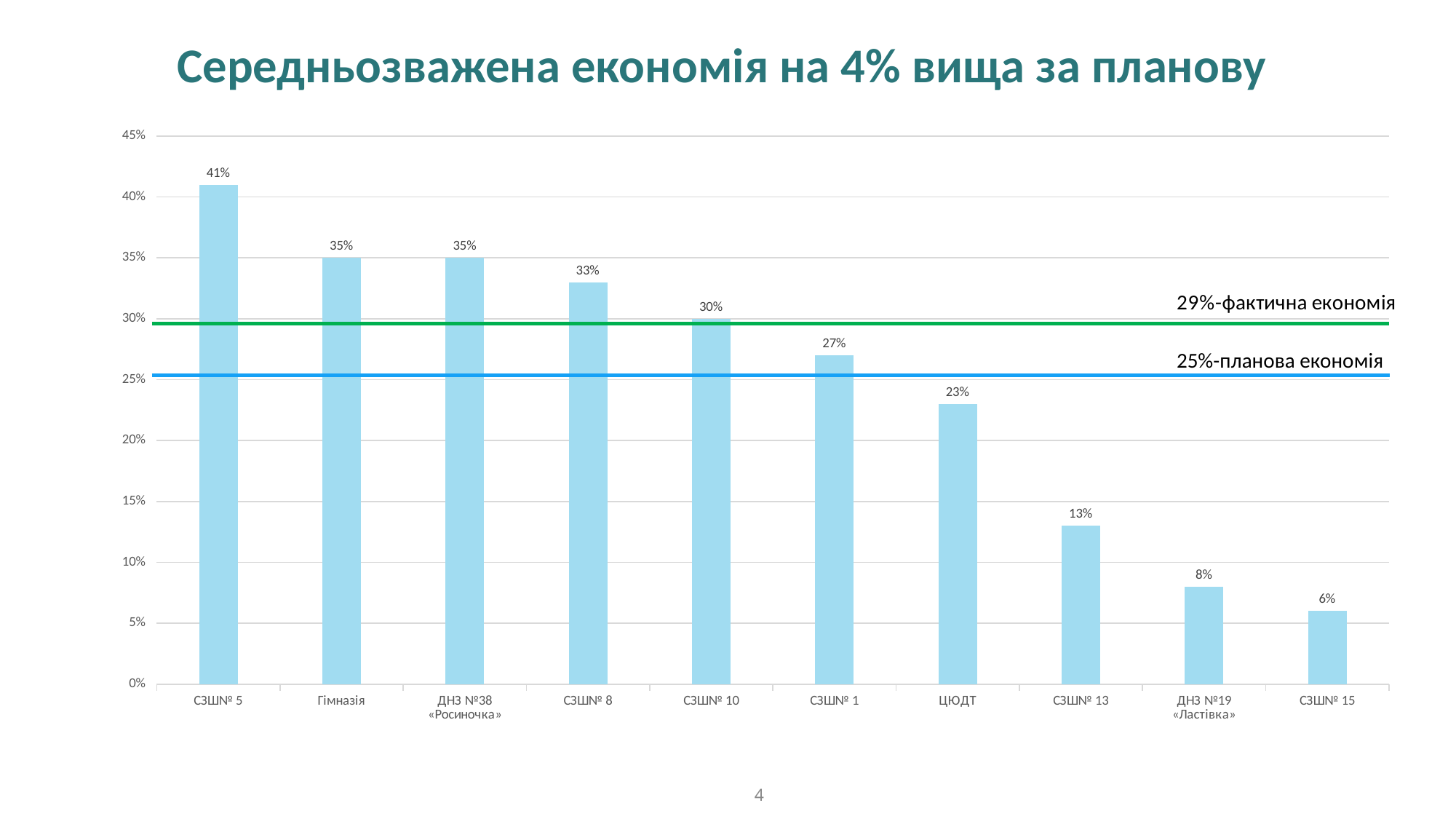
Which is larger, the value for СЗШ№ 10 or the value for СЗШ№ 13? СЗШ№ 10 What is the value for ДНЗ №19 «Ластівка»? 8% What is the difference between the values for СЗШ№ 8 and СЗШ№ 1? 6% What is the value for СЗШ№ 5? 41% Which category has the lowest value? СЗШ№ 15 What is the value for ЦЮДТ? 23% What value does the green horizontal line labelled 'фактична економія' represent? 29% What kind of chart is shown on the slide? bar chart Which category has the highest value? СЗШ№ 5 What is the difference between the values for СЗШ№ 5 and СЗШ№ 15? 35% Is the value for Гімназія greater or less than 30%? greater How many categories are shown on the x axis? 10